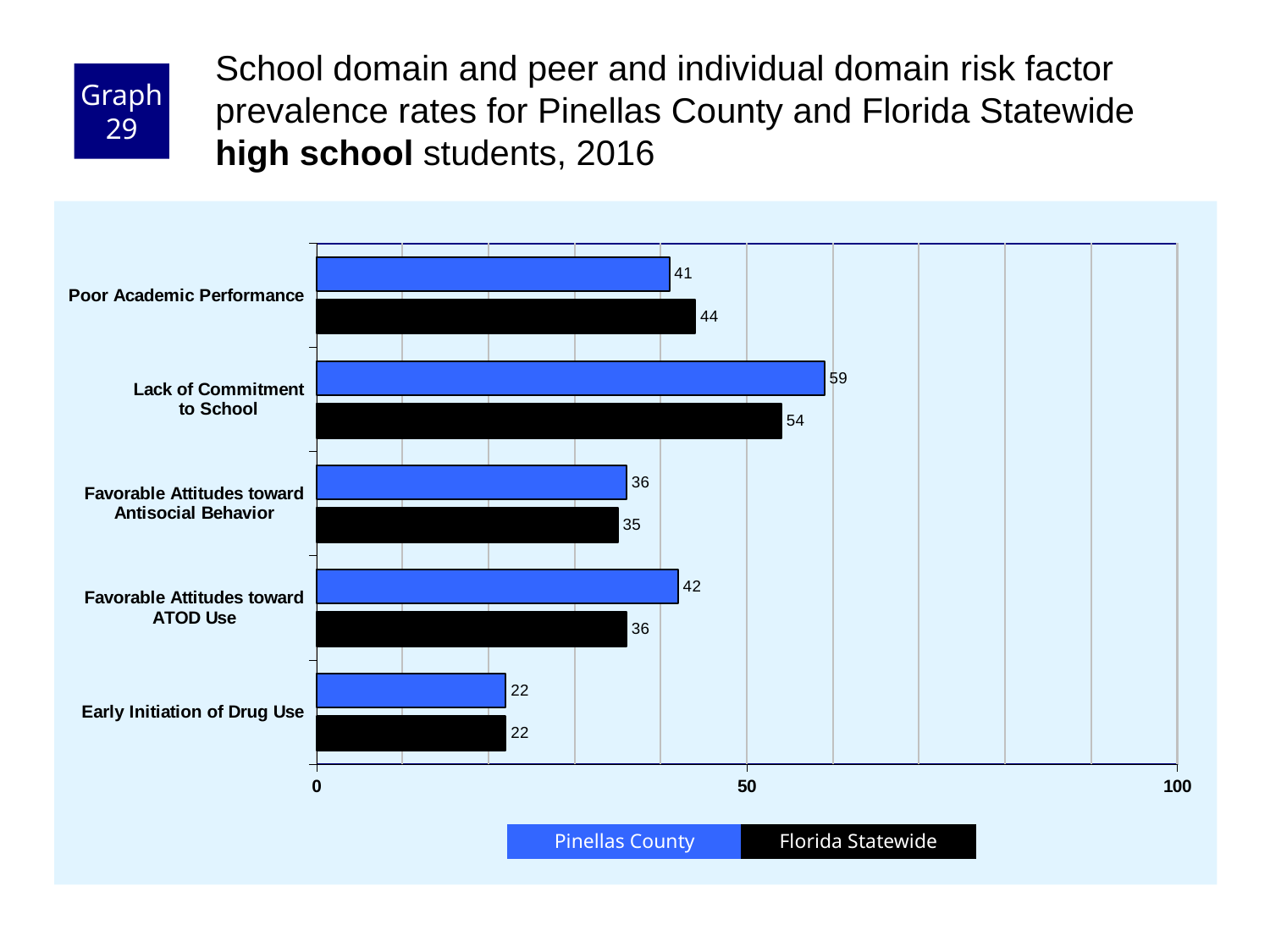
Is the Florida Statewide value for Lack of Commitment to School greater or less than 50? greater Which risk factor has the lowest Florida Statewide value? Early Initiation of Drug Use What is the difference between the Pinellas County and Florida Statewide values for Favorable Attitudes toward ATOD Use? 6 How many series does the legend list? 2 For Poor Academic Performance, which is larger: the Pinellas County value or the Florida Statewide value? Florida Statewide How many risk factor categories are shown on the chart? 5 What is the Pinellas County value for Early Initiation of Drug Use? 22 What is the Florida Statewide value for Poor Academic Performance? 44 What kind of chart is shown on the slide? bar chart Which risk factor has the highest Pinellas County value? Lack of Commitment to School Which colour represents Florida Statewide in the chart? black What is the Pinellas County value for Lack of Commitment to School? 59